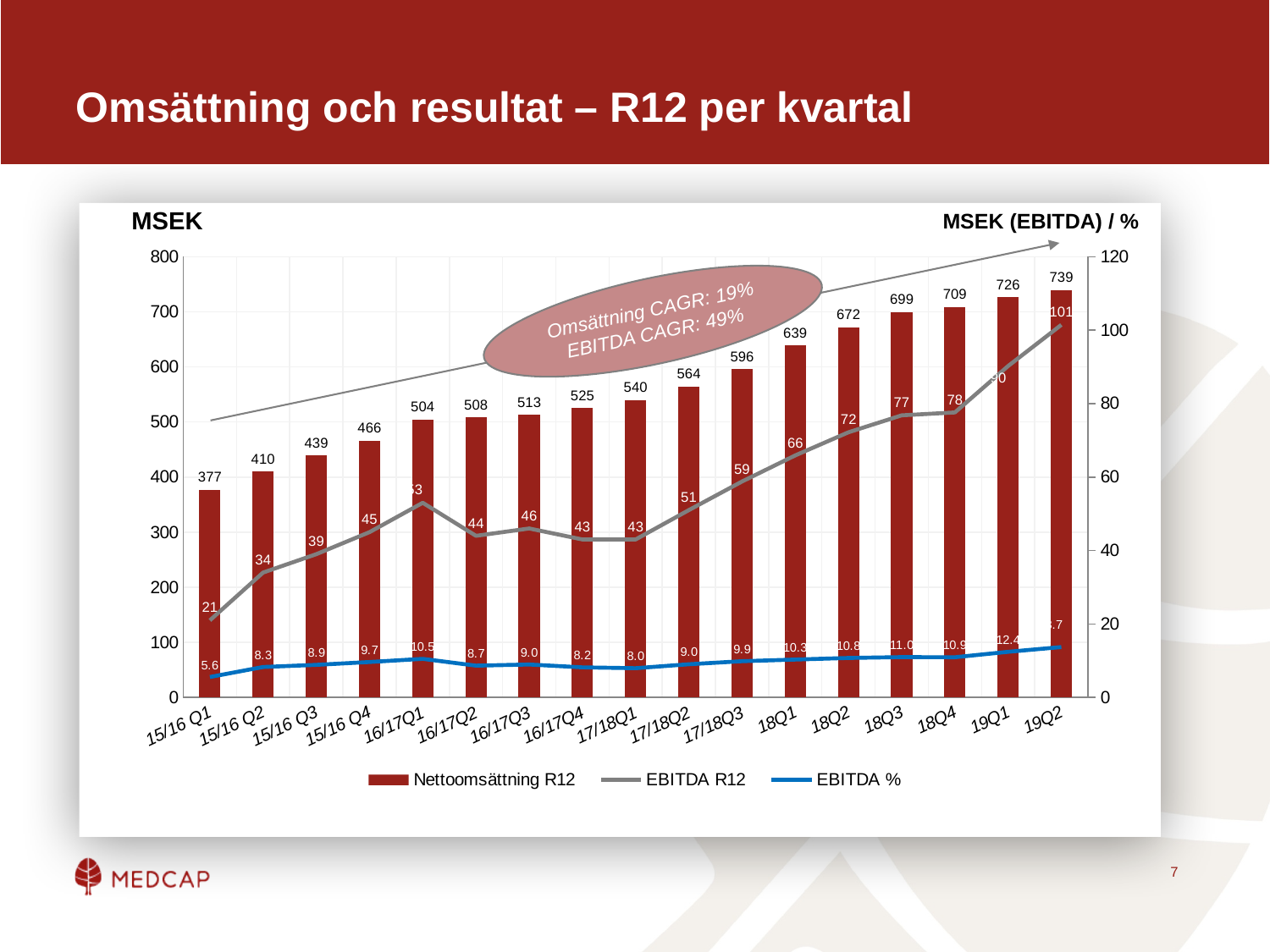
How many series does the legend list? 3 How many quarters are shown on the x axis? 17 Does the Nettoomsättning R12 rise or fall from 15/16 Q1 to 19Q2? rise What CAGR for Omsättning is stated in the callout on the chart? 19% Which quarter has the lowest EBITDA R12? 15/16 Q1 What is the EBITDA % value for 19Q1? 12.4 What is the EBITDA R12 value for 18Q3? 77 Which is larger, the EBITDA R12 for 16/17Q3 or for 17/18Q1? 16/17Q3 Which quarter has the highest Nettoomsättning R12? 19Q2 What is the difference in Nettoomsättning R12 between 19Q2 and 15/16 Q1? 362 What is the Nettoomsättning R12 value for 15/16 Q1? 377 What is the Nettoomsättning R12 value for 19Q2? 739